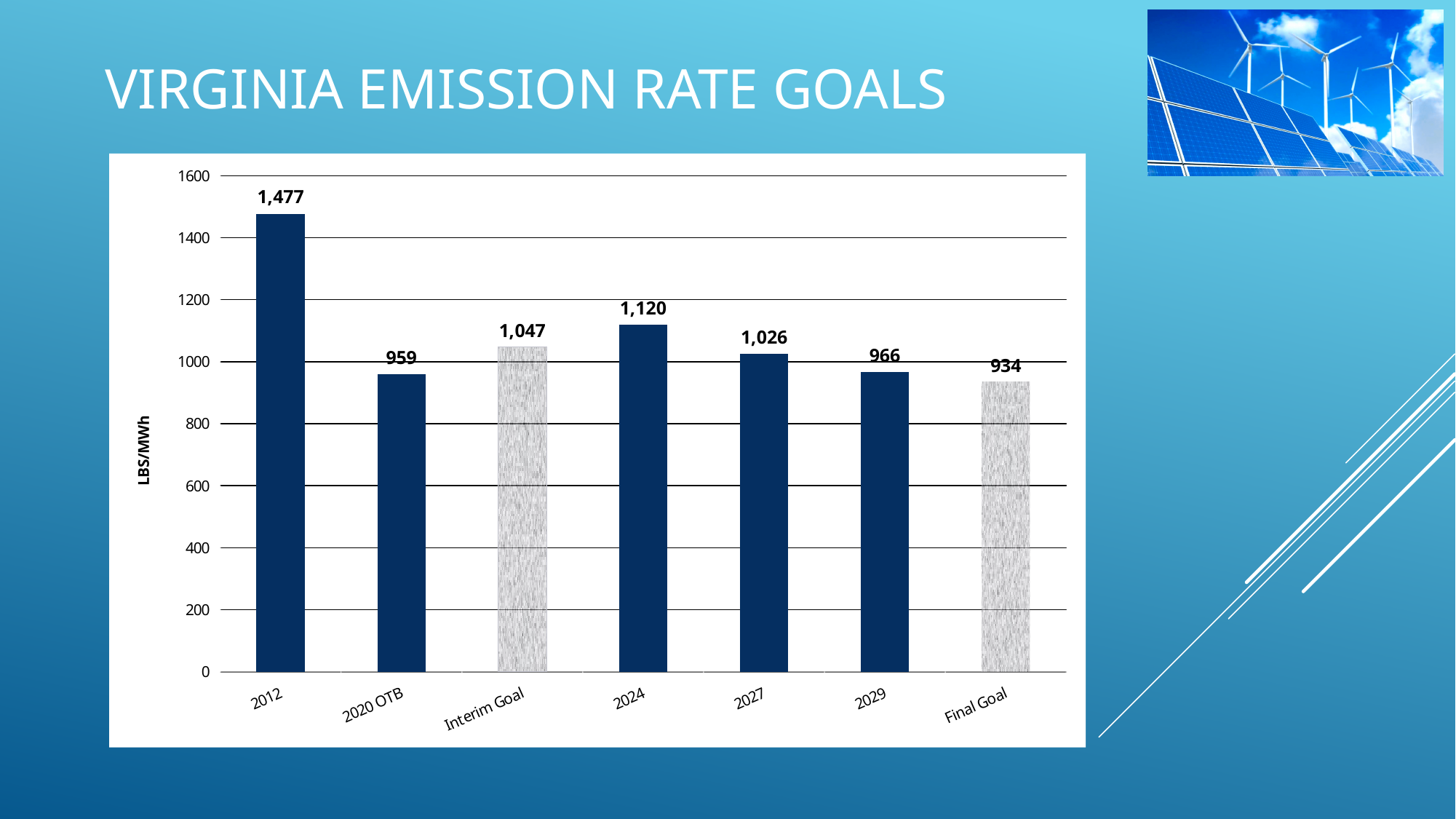
Which is larger, the value for 2024 or the value for 2029? 2024 What is the value for 2012? 1,477 Which category has the lowest value? Final Goal What is the value for the Interim Goal? 1,047 What is the value for the Final Goal? 934 What is the label on the vertical axis? LBS/MWh What is the difference between the 2012 value and the 2020 OTB value? 518 What is the value for 2027? 1,026 Is the value for 2029 greater or less than 1000? less What kind of chart is shown on the slide? Bar chart How many categories are shown on the x axis? 7 Which category has the highest value? 2012